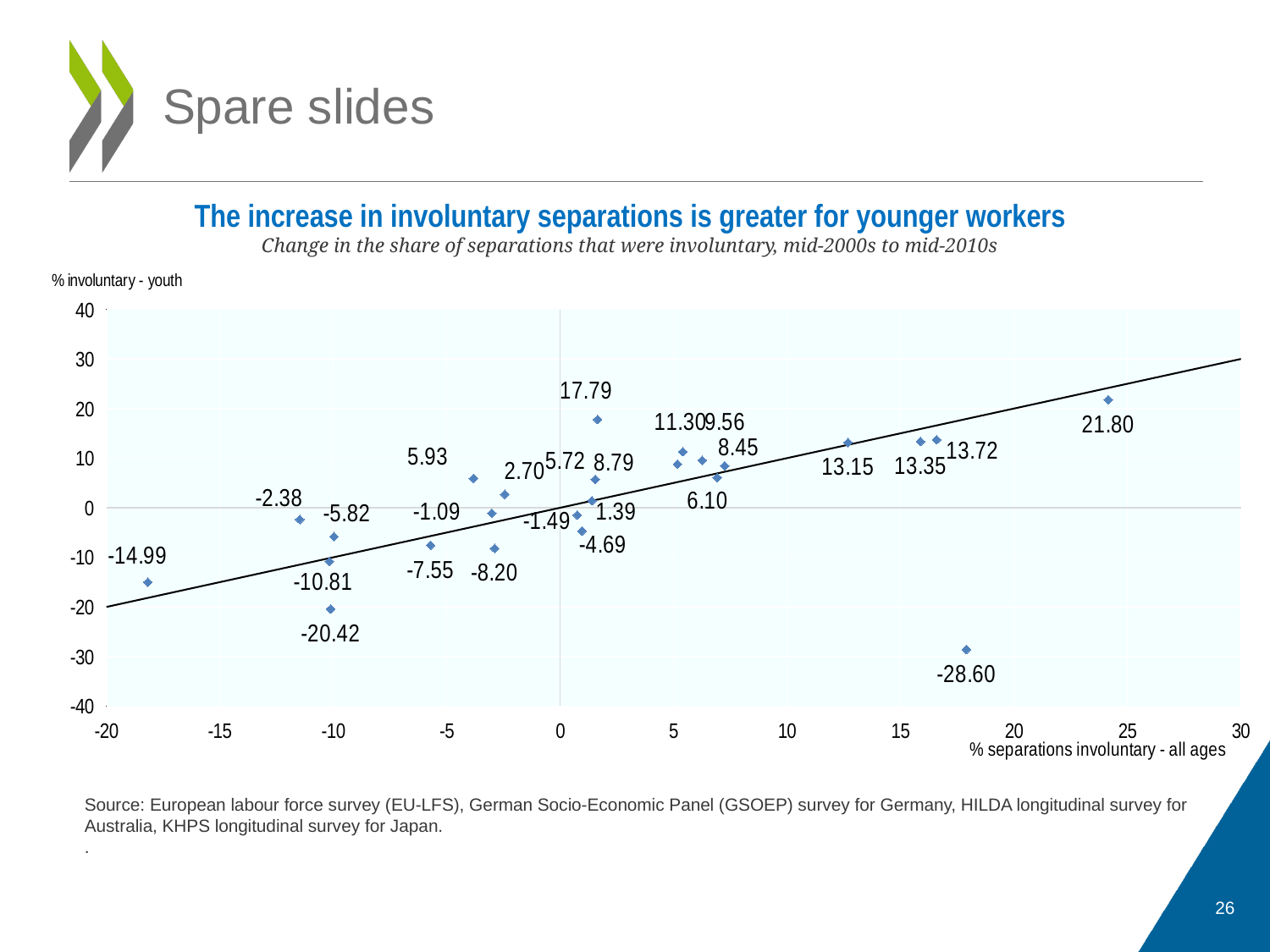
Is the x-axis value of the point labelled -28.60 greater or less than 15? greater What kind of chart is shown on the slide? scatter chart Which labelled value is larger, 11.30 or 9.56? 11.30 What is the lowest data label value shown on the chart? -28.60 Does the fitted trend line rise or fall as the x-axis value increases? rises Is the x-axis value of the point labelled -14.99 greater or less than -15? less What is the highest data label value shown on the chart? 21.80 What is the title of the chart? The increase in involuntary separations is greater for younger workers Is the x-axis value of the point labelled 21.80 greater or less than 20? greater What is the label of the vertical axis? % involuntary - youth What is the difference between the highest labelled value (21.80) and the lowest labelled value (-28.60)? 50.40 Which labelled value is larger, 13.72 or 13.35? 13.72